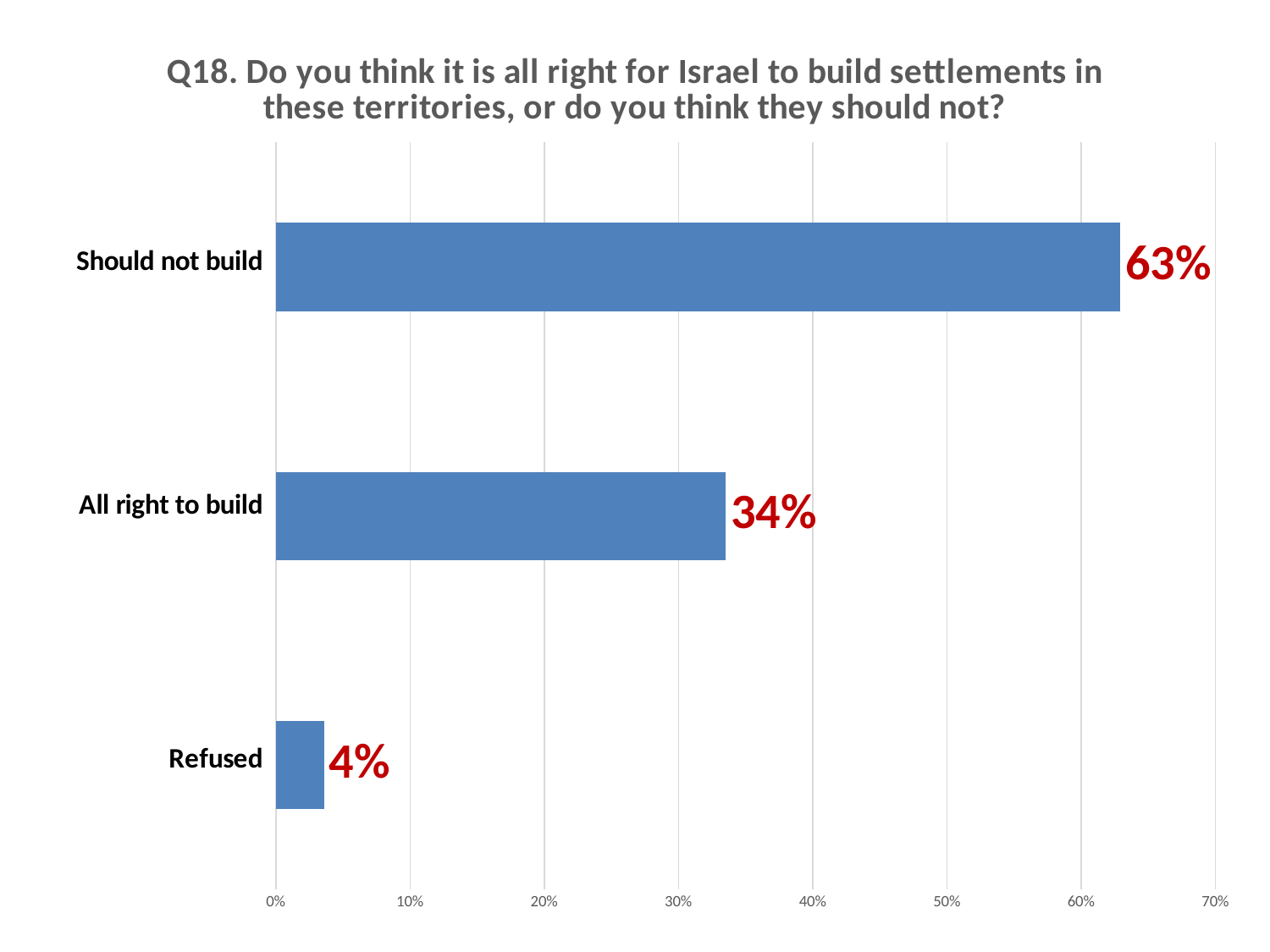
Which is larger, the value for 'All right to build' or the value for 'Refused'? All right to build Which response category has the lowest value? Refused What kind of chart is shown on the slide? Bar chart Which response category has the highest value? Should not build What is the difference in percentage points between 'All right to build' and 'Refused'? 30 What is the difference in percentage points between 'Should not build' and 'All right to build'? 29 What percentage of respondents said Israel should not build settlements? 63% Is the value for 'Should not build' greater or less than 60%? greater What percentage of respondents said it is all right to build? 34% What percentage of respondents refused to answer? 4% What is the highest value shown on the horizontal axis? 70% How many response categories are shown in the chart? 3